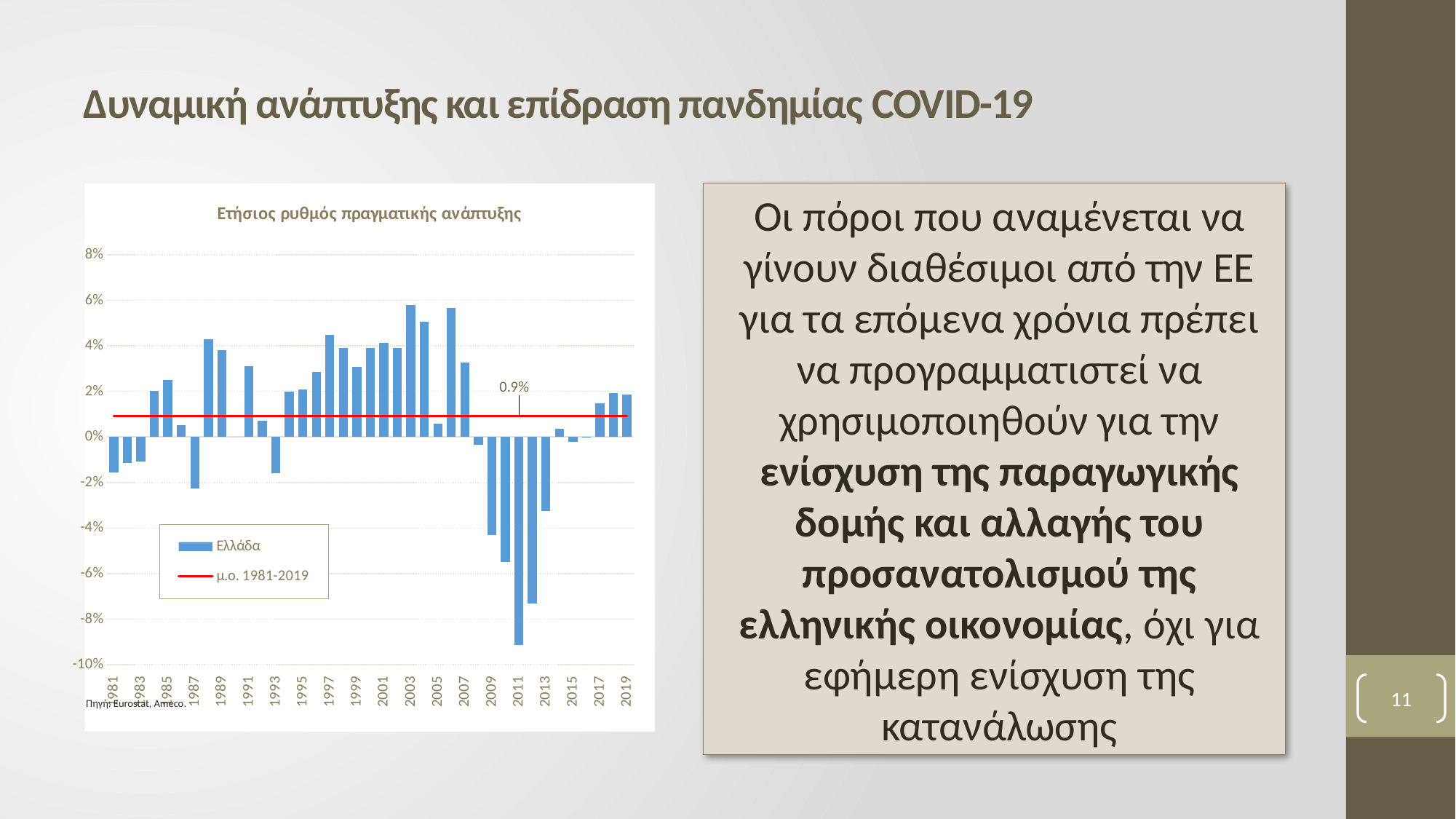
Is the value for 2011 greater or less than -8%? less Which year has the lowest growth rate in the chart? 2011 Which year has the larger growth rate, 2003 or 2009? 2003 Is the value for 2003 greater or less than 4%? greater How many series does the chart legend list? 2 Which year has the larger growth rate, 2011 or 2012? 2012 What is the name of the series shown by the blue bars in the legend? Ελλάδα Is the value for 2010 greater or less than -4%? less What value is labelled on the red average line (μ.ο. 1981-2019)? 0.9% What kind of chart is shown on the slide? bar chart Do the values rise or fall from 2008 to 2011? fall What is the title of the chart? Ετήσιος ρυθμός πραγματικής ανάπτυξης